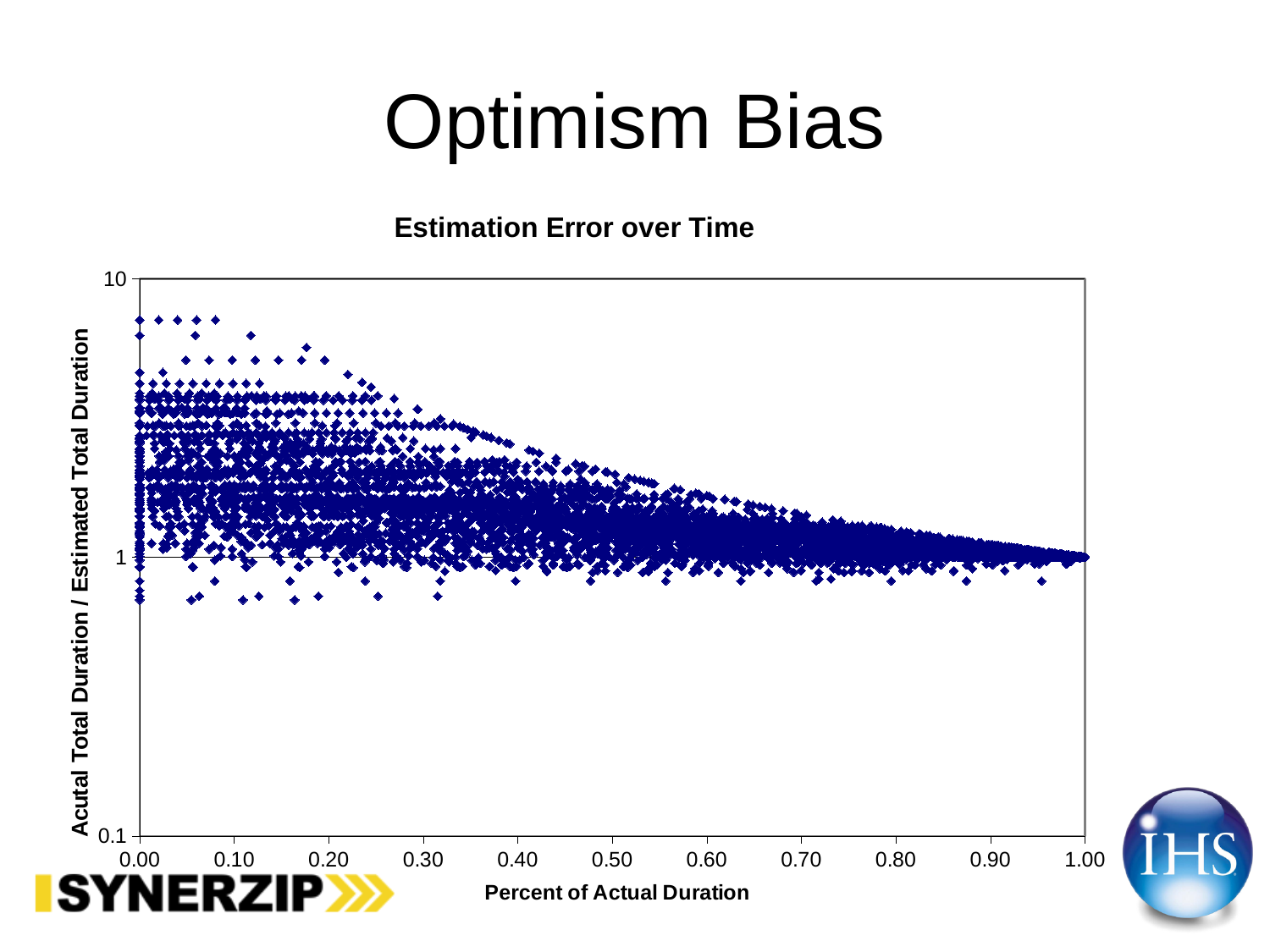
What is the label of the x axis? Percent of Actual Duration What is the highest value shown on the x axis? 1.00 What is the highest value shown on the y axis? 10 Do any plotted points reach the value 10 on the y axis? No What kind of chart is shown on the slide? Scatter plot Does the vertical spread of the points get wider or narrower as the x value increases? Narrower What is the lowest value shown on the y axis? 0.1 What is the title of the chart? Estimation Error over Time As Percent of Actual Duration increases toward 1.00, do the plotted values converge toward 1 or spread further apart? Converge toward 1 Are most of the plotted points above or below the value 1 on the y axis? Above